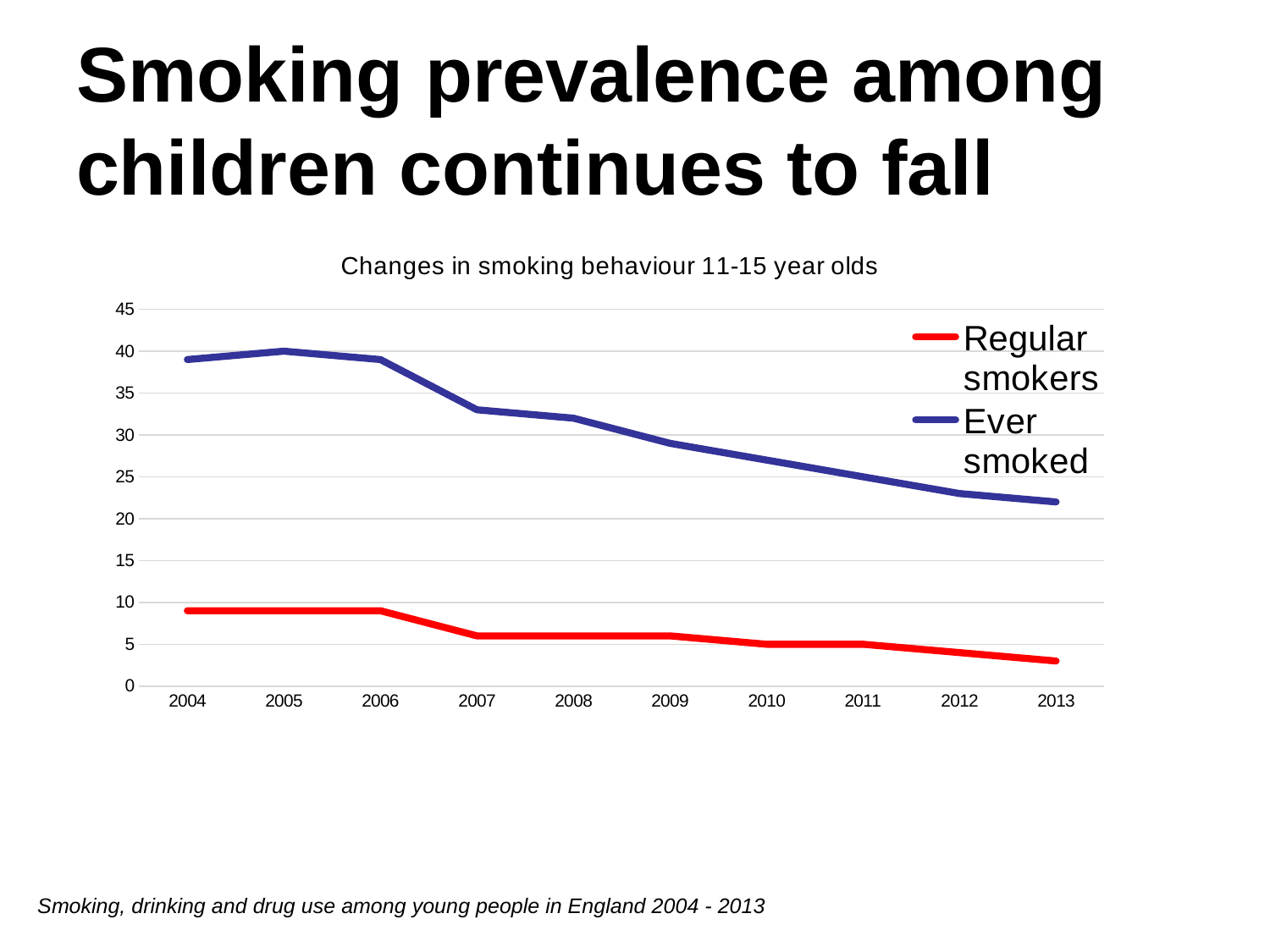
In which year is the Ever smoked value lowest? 2013 How many series does the legend list? 2 Does the Ever smoked line rise or fall from 2004 to 2013? fall Does the Regular smokers line rise or fall from 2004 to 2013? fall Is the value for Regular smokers in 2013 greater or less than 5? less How many years are shown along the x axis? 10 Is the value for Regular smokers in 2004 greater or less than 10? less Is the value for Ever smoked in 2013 greater or less than 25? less In 2008, which series has the larger value, Regular smokers or Ever smoked? Ever smoked What is the title of the chart? Changes in smoking behaviour 11-15 year olds What kind of chart is shown on the slide? line chart